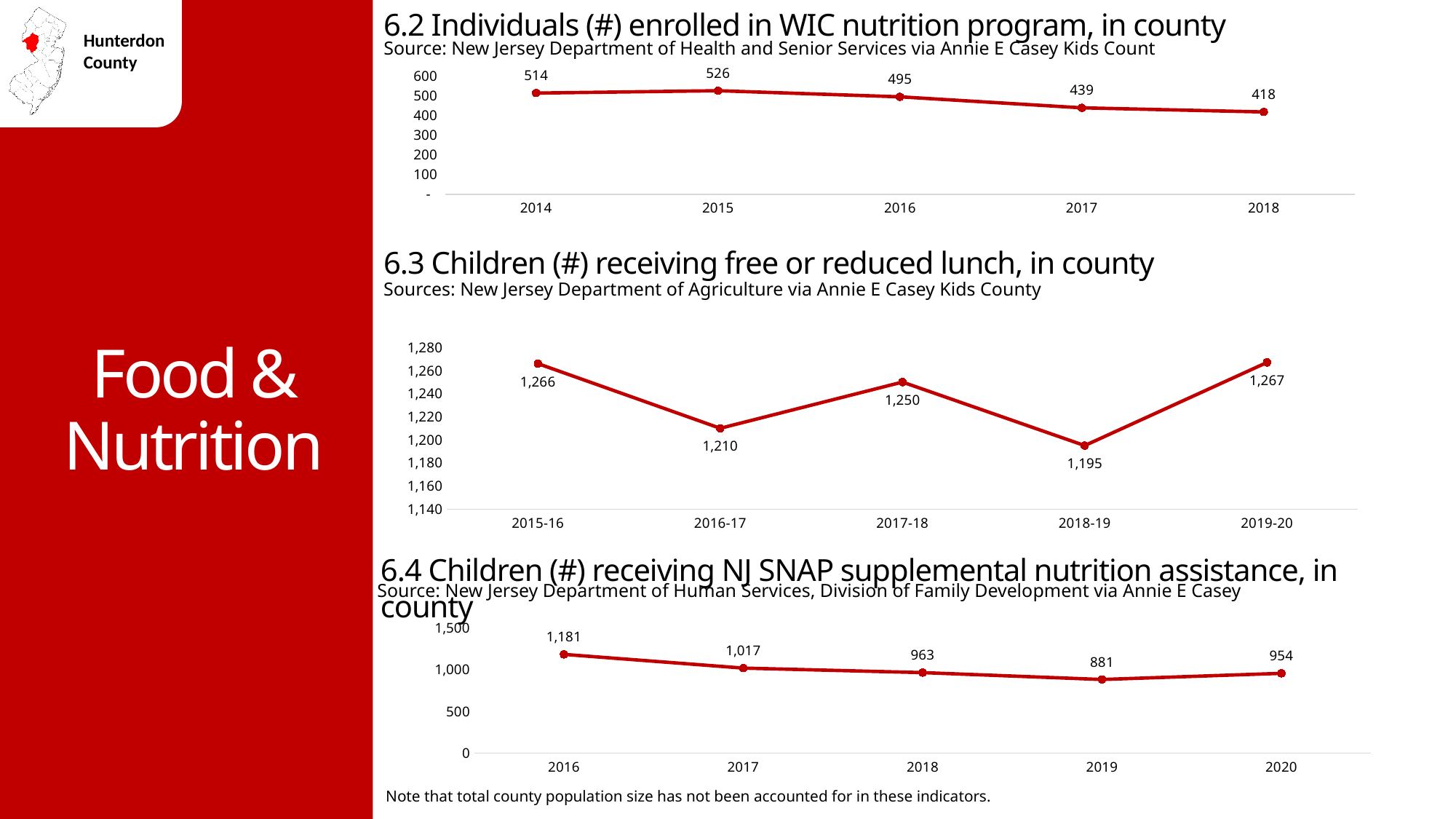
In the chart '6.3 Children (#) receiving free or reduced lunch, in county', which school year has the lowest value? 2018-19 In the chart '6.2 Individuals (#) enrolled in WIC nutrition program, in county', how many years are plotted? 5 In the chart '6.4 Children (#) receiving NJ SNAP supplemental nutrition assistance, in county', what is the difference between the 2019 and 2020 values? 73 In the chart '6.4 Children (#) receiving NJ SNAP supplemental nutrition assistance, in county', what is the value for 2017? 1,017 In the chart '6.2 Individuals (#) enrolled in WIC nutrition program, in county', what is the value for 2016? 495 What kind of chart is '6.3 Children (#) receiving free or reduced lunch, in county'? Line chart In the chart '6.3 Children (#) receiving free or reduced lunch, in county', what is the value for 2018-19? 1,195 In the chart '6.4 Children (#) receiving NJ SNAP supplemental nutrition assistance, in county', which year has the highest value? 2016 In the chart '6.2 Individuals (#) enrolled in WIC nutrition program, in county', do the values generally rise or fall from 2015 to 2018? Fall In the chart '6.3 Children (#) receiving free or reduced lunch, in county', which is larger, the value for 2016-17 or 2017-18? 2017-18 In the chart '6.2 Individuals (#) enrolled in WIC nutrition program, in county', what is the difference between the 2014 and 2018 values? 96 In the chart '6.2 Individuals (#) enrolled in WIC nutrition program, in county', which year has the highest value? 2015